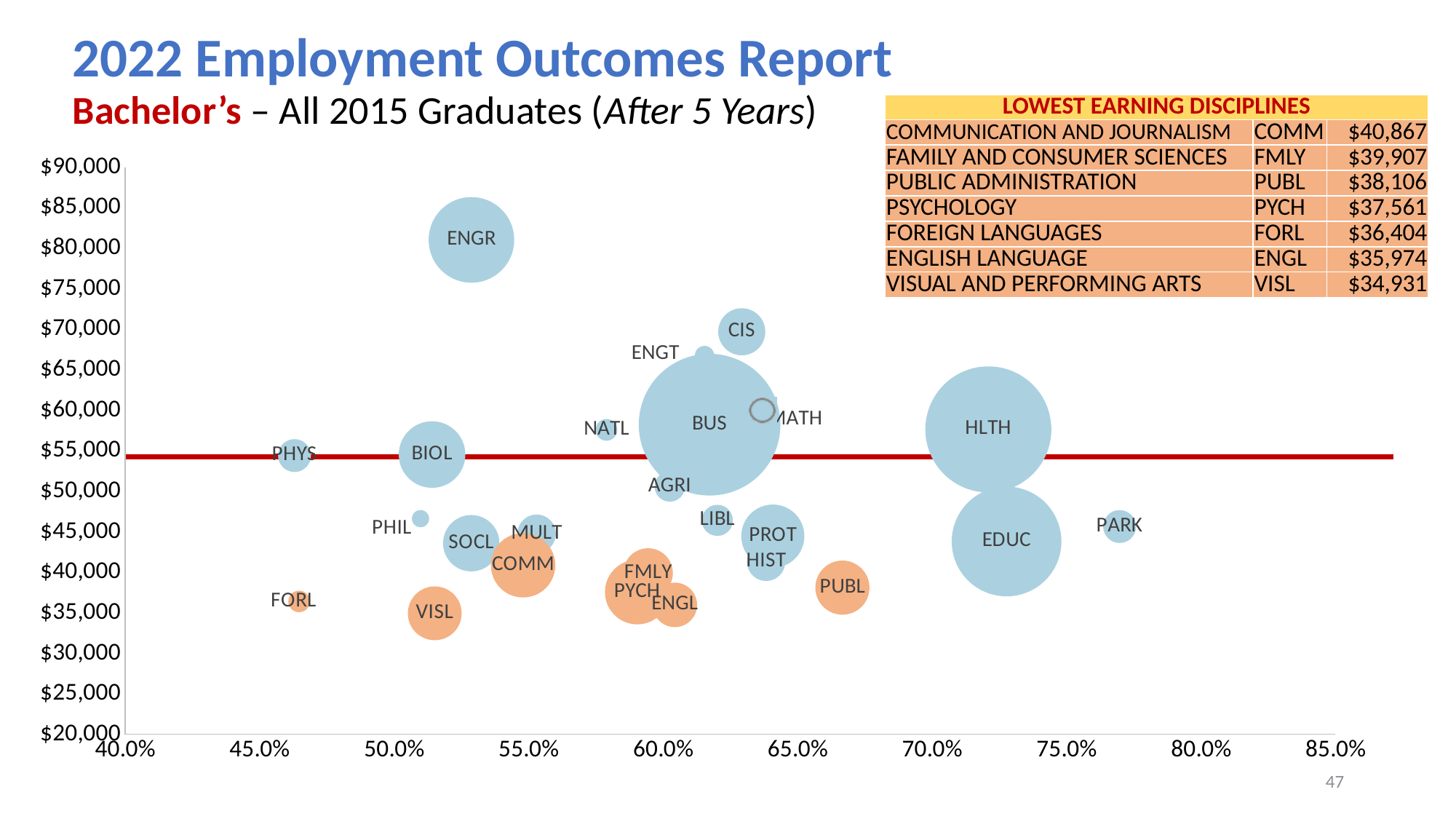
Is the x-axis value for HLTH greater or less than 70.0%? greater Which discipline has the lowest earnings on the chart? VISL What kind of chart is shown on the slide? bubble chart Is the earnings value for EDUC greater or less than $50,000? less Is the x-axis value for FORL greater or less than 50.0%? less Which has higher earnings, ENGR or HLTH? ENGR According to the Lowest Earning Disciplines table, what is the earnings value for PUBL? $38,106 How many disciplines are listed in the Lowest Earning Disciplines table? 7 Which has higher earnings, HLTH or EDUC? HLTH Which discipline has the highest earnings on the chart? ENGR